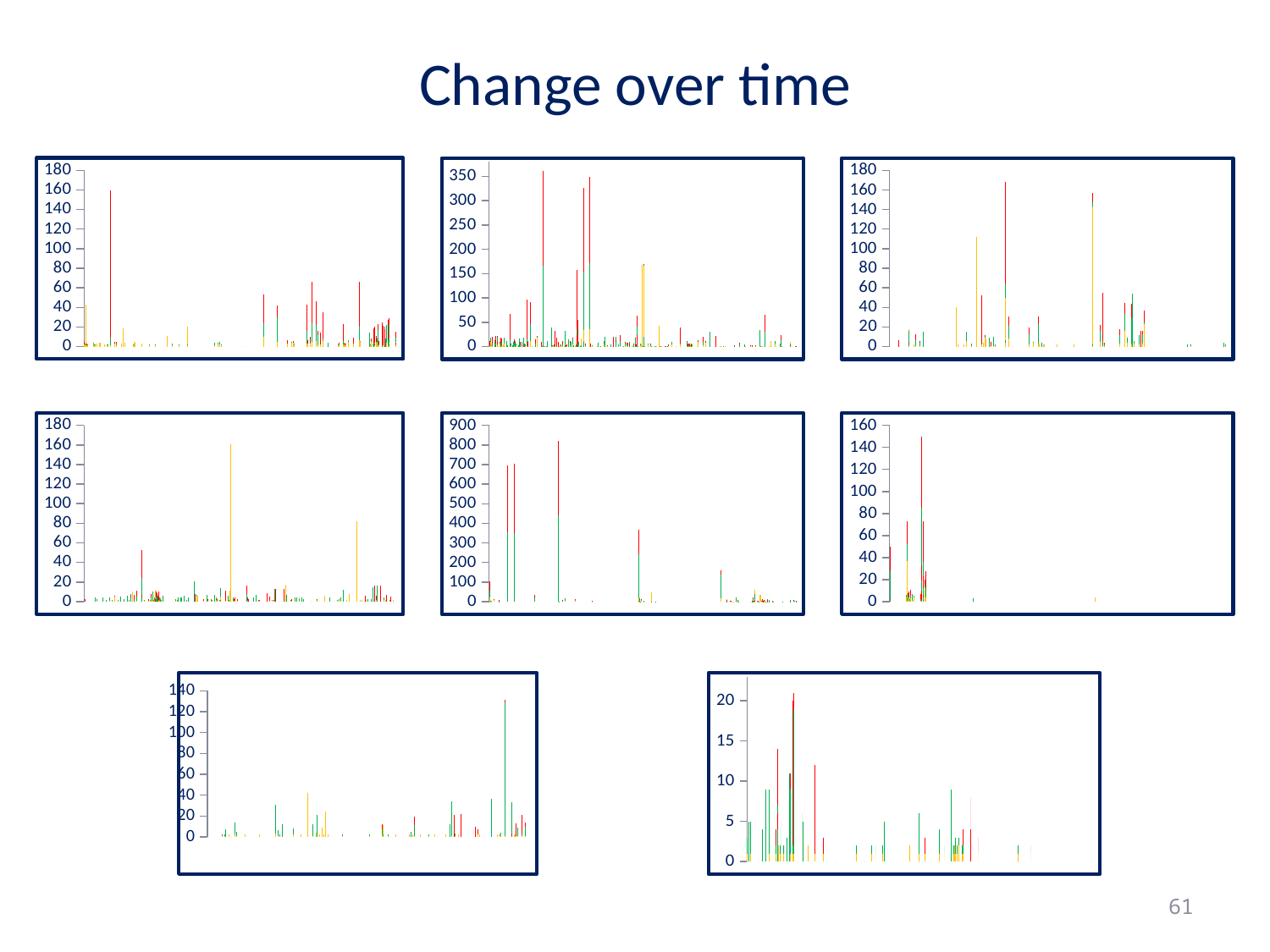
In the middle-left chart, is the tallest bar greater or less than 140? greater In the middle-right chart, is the tallest bar greater or less than 120? greater In the top-middle chart, is the tallest bar greater or less than 300? greater How many charts are shown on the slide? 8 What is the title of the slide containing these charts? Change over time What kind of chart is the top-left chart? bar chart